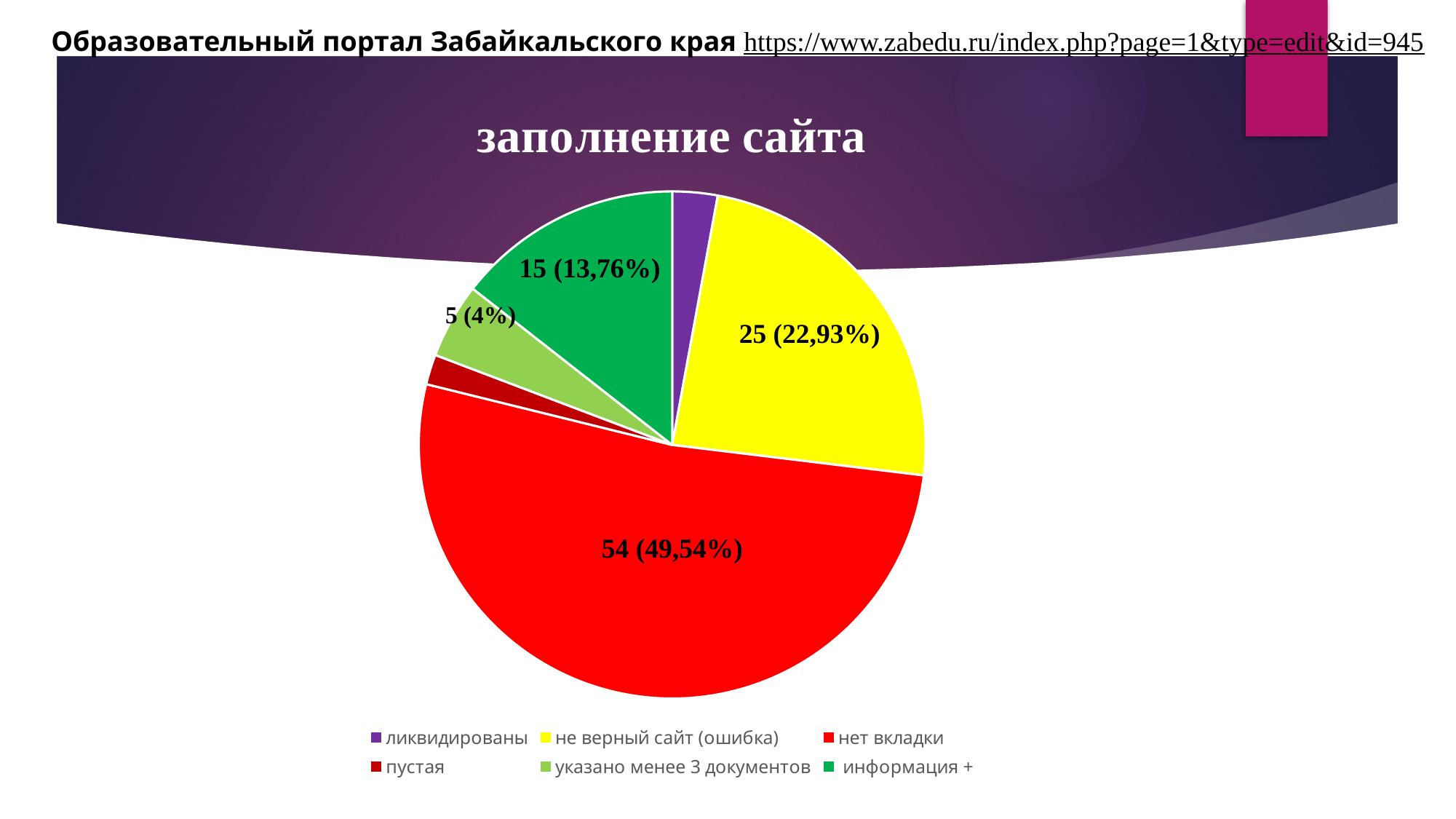
What is the title of the chart? заполнение сайта What is the value shown for the 'нет вкладки' slice? 54 (49,54%) Which category has the largest slice of the pie? нет вкладки What is the value shown for the 'указано менее 3 документов' slice? 5 (4%) What is the value shown for the 'не верный сайт (ошибка)' slice? 25 (22,93%) How many categories does the legend list? 6 What is the value shown for the 'информация +' slice? 15 (13,76%) What colour is the 'нет вкладки' slice? red What share of the pie does the 'нет вкладки' slice represent? 49,54% What is the difference between the counts for 'нет вкладки' and 'не верный сайт (ошибка)'? 29 What kind of chart is shown on the slide? pie chart Which is larger: the slice for 'информация +' or the slice for 'указано менее 3 документов'? информация +